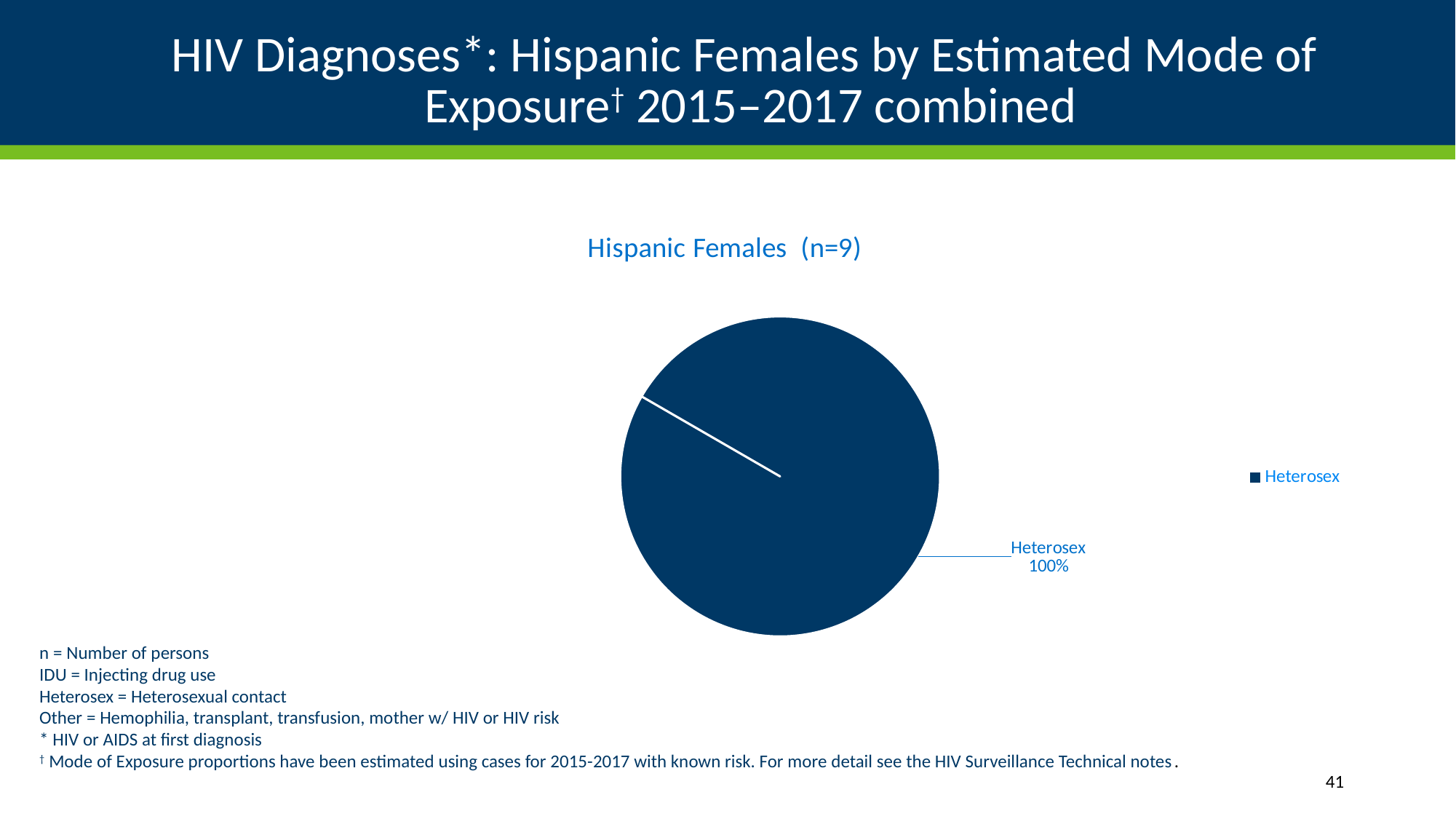
Is the share for Heterosex greater or less than 50%? greater What is the value of n shown in the chart title? 9 What is the title of the chart? Hispanic Females (n=9) How many entries does the legend list? 1 What kind of chart is shown on the slide? pie chart What share of the pie does the Heterosex slice represent? 100% Which mode of exposure category is shown in the legend? Heterosex What is the data label value shown for Heterosex? 100% How many slices does the pie chart have? 1